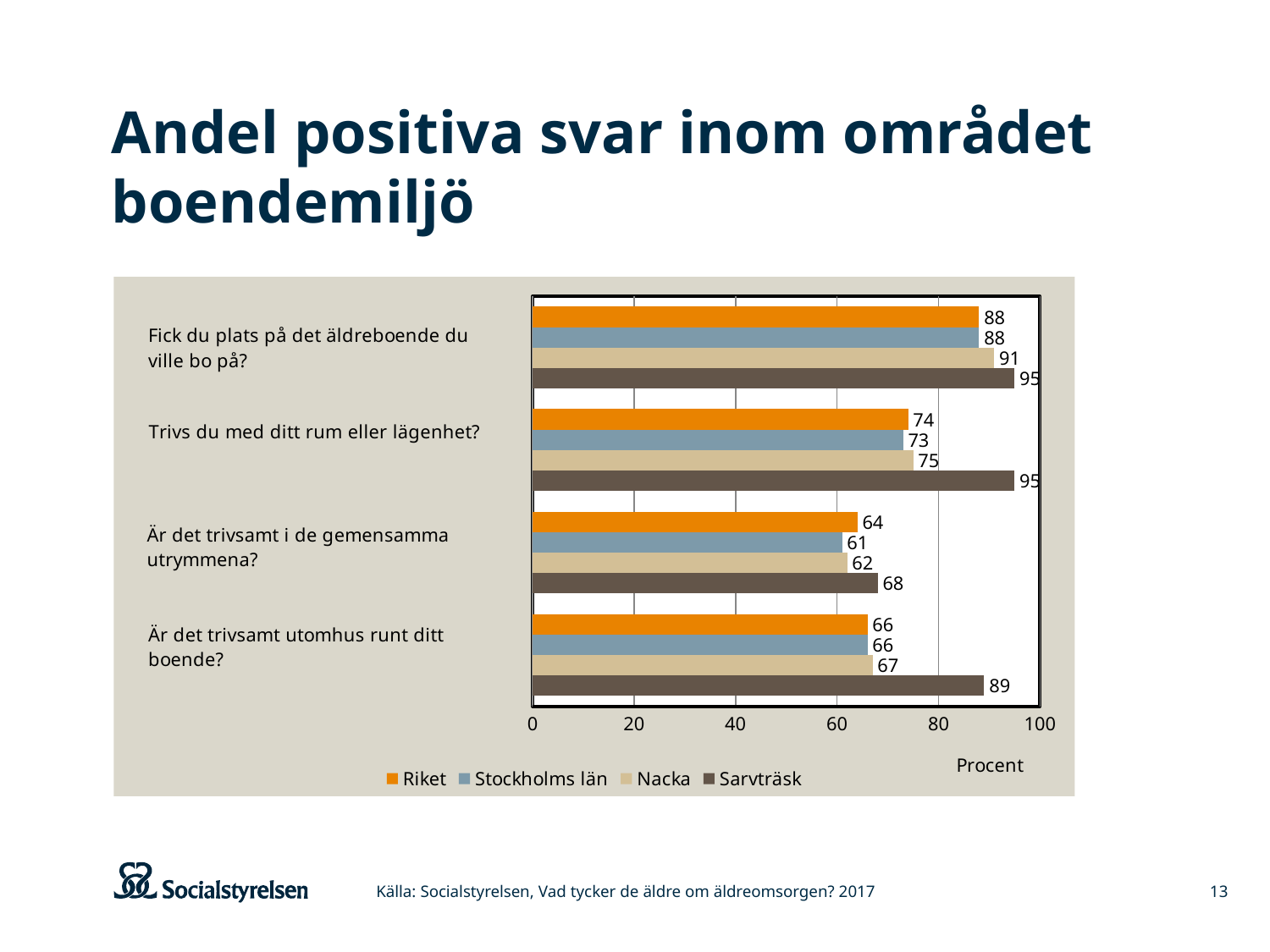
Which series has the highest value on "Är det trivsamt utomhus runt ditt boende?" Sarvträsk What is the label on the horizontal axis? Procent What is the value for Stockholms län on "Är det trivsamt i de gemensamma utrymmena?" 61 What is the value for Sarvträsk on "Trivs du med ditt rum eller lägenhet?" 95 Which series has the lowest value on "Är det trivsamt i de gemensamma utrymmena?" Stockholms län What is the value for Riket on "Är det trivsamt utomhus runt ditt boende?" 66 Which is larger on "Är det trivsamt utomhus runt ditt boende?": Sarvträsk or Nacka? Sarvträsk How many series does the legend list? 4 What is the difference between Sarvträsk and Riket on "Trivs du med ditt rum eller lägenhet?" 21 How many questions (categories) are shown on the chart? 4 What is the value for Nacka on "Fick du plats på det äldreboende du ville bo på?" 91 What kind of chart is shown on the slide? Bar chart